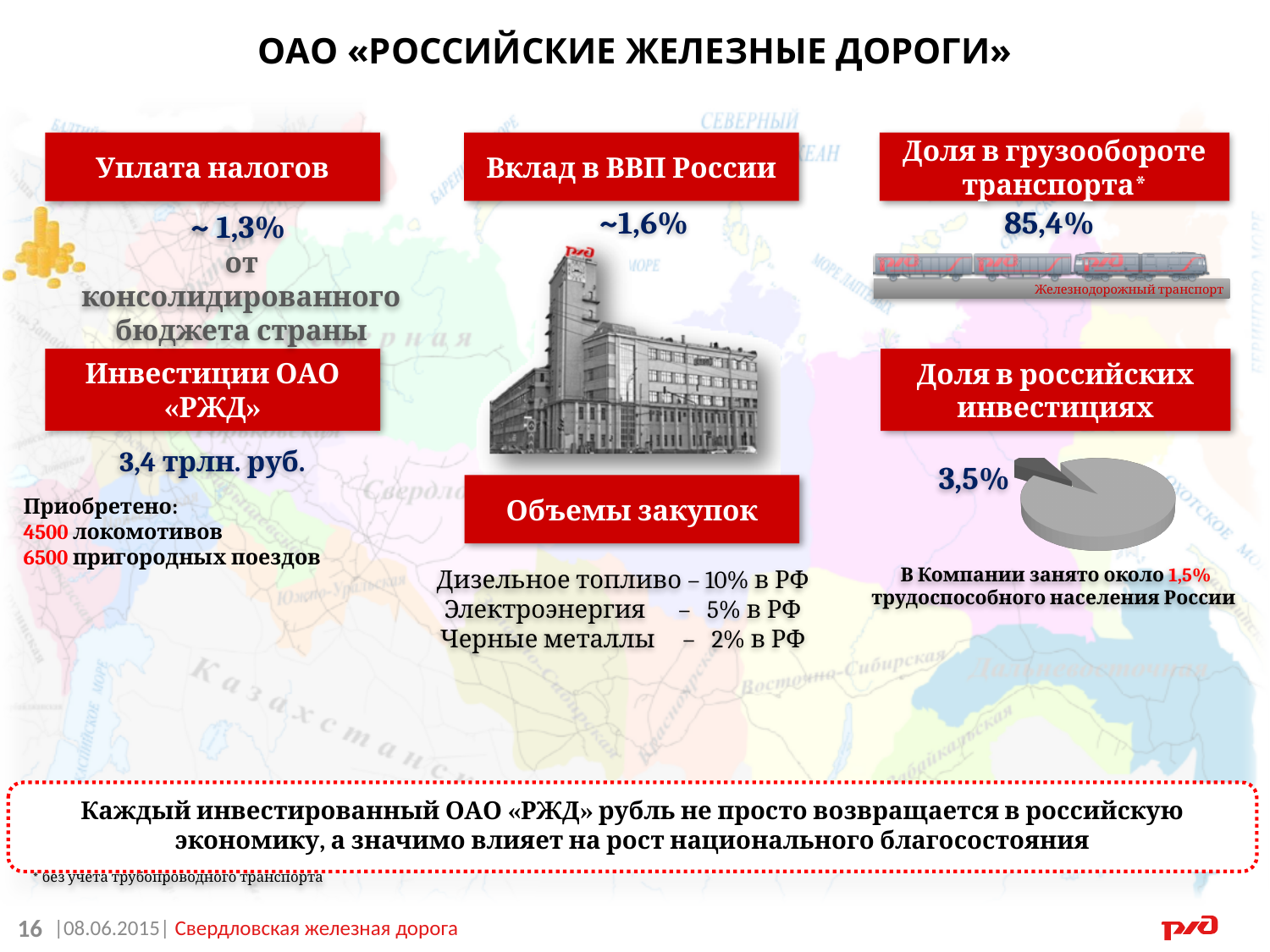
Does the pie chart under «Доля в российских инвестициях» show a legend? No In the pie chart under «Доля в российских инвестициях», is the share of the separated slice greater or less than 10%? less What is the heading printed above the pie chart on the slide? Доля в российских инвестициях In the pie chart under «Доля в российских инвестициях», is the separated slice labelled 3,5% larger or smaller than the remaining slice? smaller What kind of chart is shown under the heading «Доля в российских инвестициях»? pie chart In the pie chart under «Доля в российских инвестициях», which slice is the largest: the separated slice or the remaining slice? the remaining slice How many slices does the pie chart under «Доля в российских инвестициях» have? 2 In the pie chart under «Доля в российских инвестициях», what share is printed next to the separated slice? 3,5%